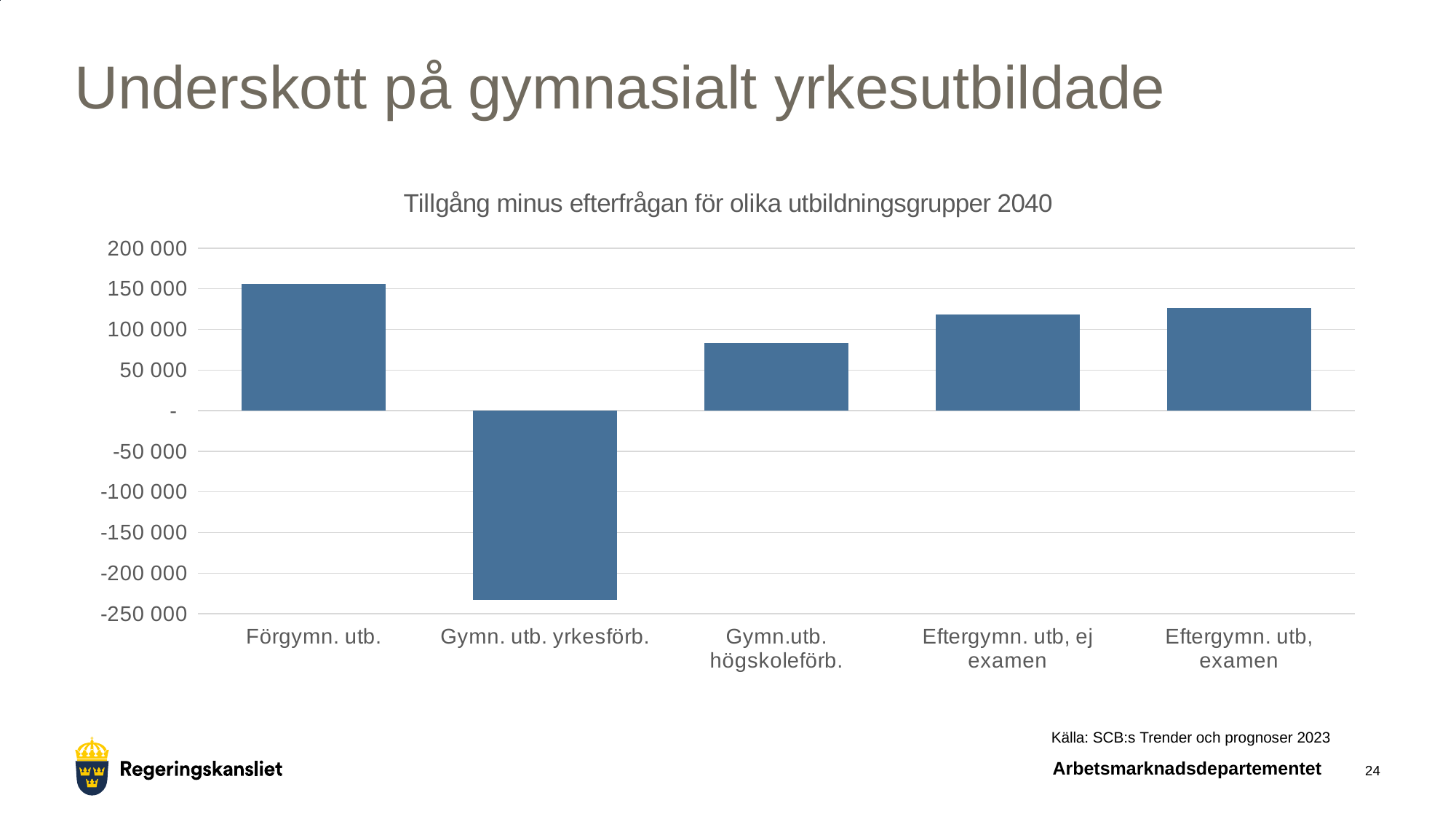
Which category has the lowest value in the chart? Gymn. utb. yrkesförb. Which is larger, the value for Förgymn. utb. or the value for Eftergymn. utb, examen? Förgymn. utb. Which category has the highest value in the chart? Förgymn. utb. What is the title of the chart? Tillgång minus efterfrågan för olika utbildningsgrupper 2040 Which is larger, the value for Förgymn. utb. or the value for Gymn.utb. högskoleförb.? Förgymn. utb. Is the value for Eftergymn. utb, examen greater or less than 100 000? greater What kind of chart is shown on the slide? Bar chart How many categories are shown on the x axis of the chart? 5 Is the value for Förgymn. utb. greater or less than 100 000? greater Is the value for Gymn. utb. yrkesförb. greater or less than -200 000? less Which category is the only one with a negative value? Gymn. utb. yrkesförb.